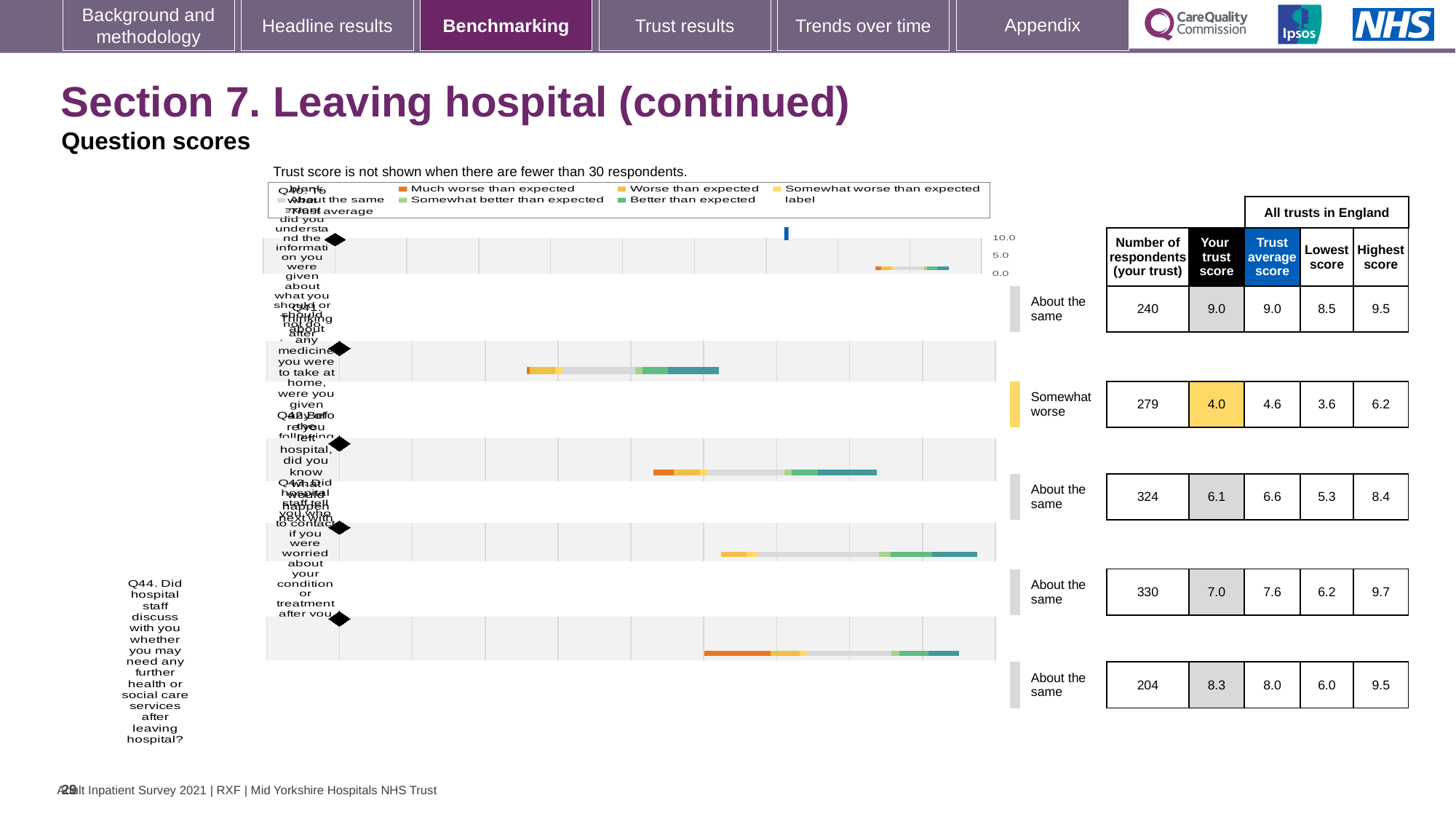
What is the Lowest score across all trusts in England for Q44? 6.0 How many of the question rows are rated 'About the same'? 4 Which question row has the lowest 'Your trust score' in the table? The second row (rated Somewhat worse), with 4.0 What is the 'Your trust score' for Q44 (Did hospital staff discuss with you whether you may need any further health or social care services after leaving hospital?)? 8.3 How many respondents are shown for the question row rated 'Somewhat worse'? 279 What kind of chart is used to show the question scores? Bar chart How many question rows are plotted on the chart? 5 How many respondents (your trust) are shown for Q44? 204 For Q44, what is the difference between the trust's score (8.3) and the Trust average score (8.0)? 0.3 What is the Trust average score for Q44? 8.0 What is the Highest score across all trusts in England for Q44? 9.5 For Q44, which is larger: the trust's own score or the Trust average score? Your trust score